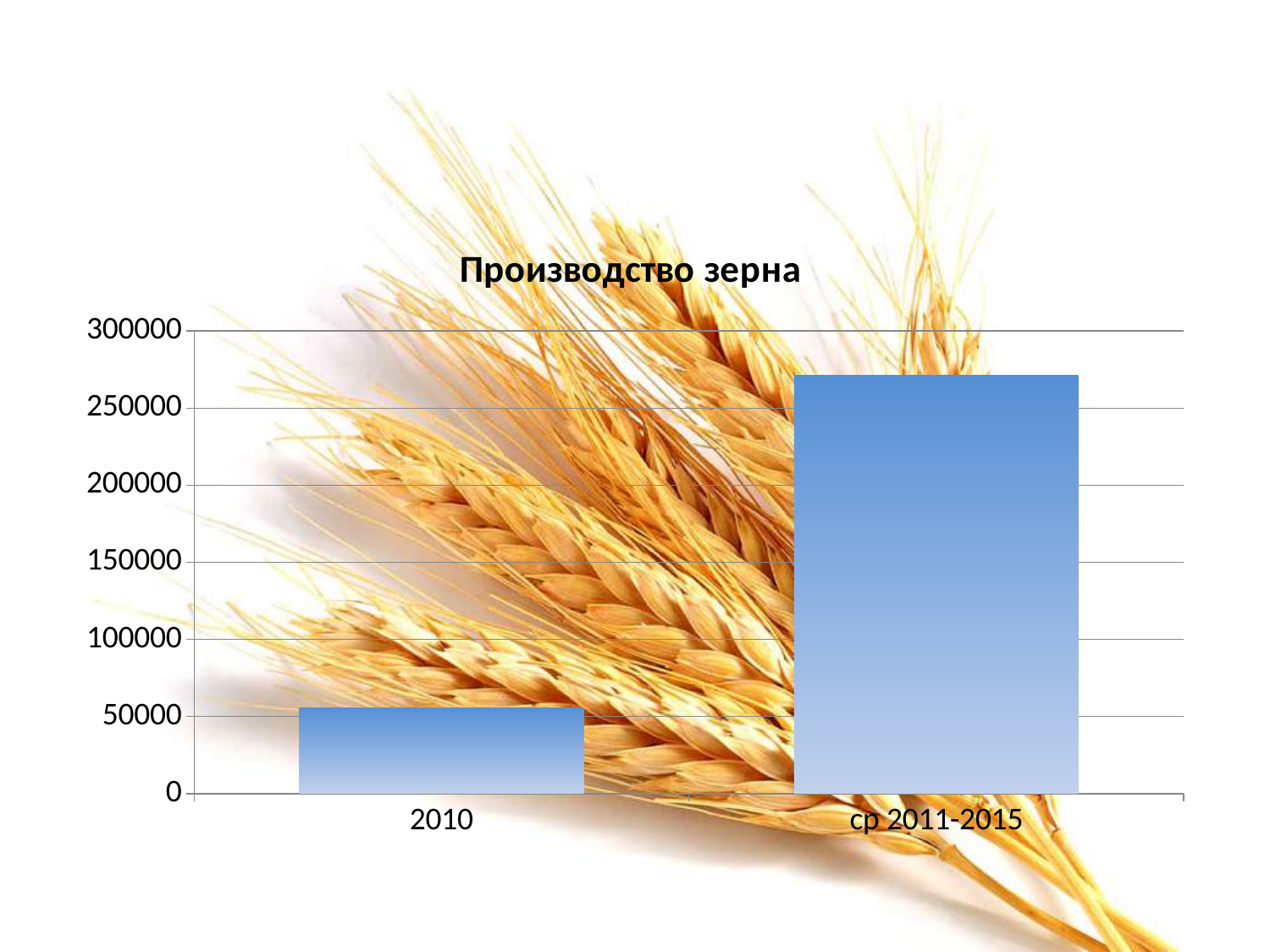
Is the value for ср 2011-2015 greater or less than 300000? less Which category has the highest value in the chart? ср 2011-2015 Do the values rise or fall from 2010 to ср 2011-2015? rise How many categories are shown on the x axis of the chart? 2 Which category has the lowest value in the chart? 2010 Is the value for 2010 greater or less than 100000? less What kind of chart is shown on the slide? bar chart Which is larger, the value for 2010 or the value for ср 2011-2015? ср 2011-2015 Is the value for ср 2011-2015 greater or less than 250000? greater What is the highest tick value shown on the vertical axis? 300000 What is the title of the chart? Производство зерна